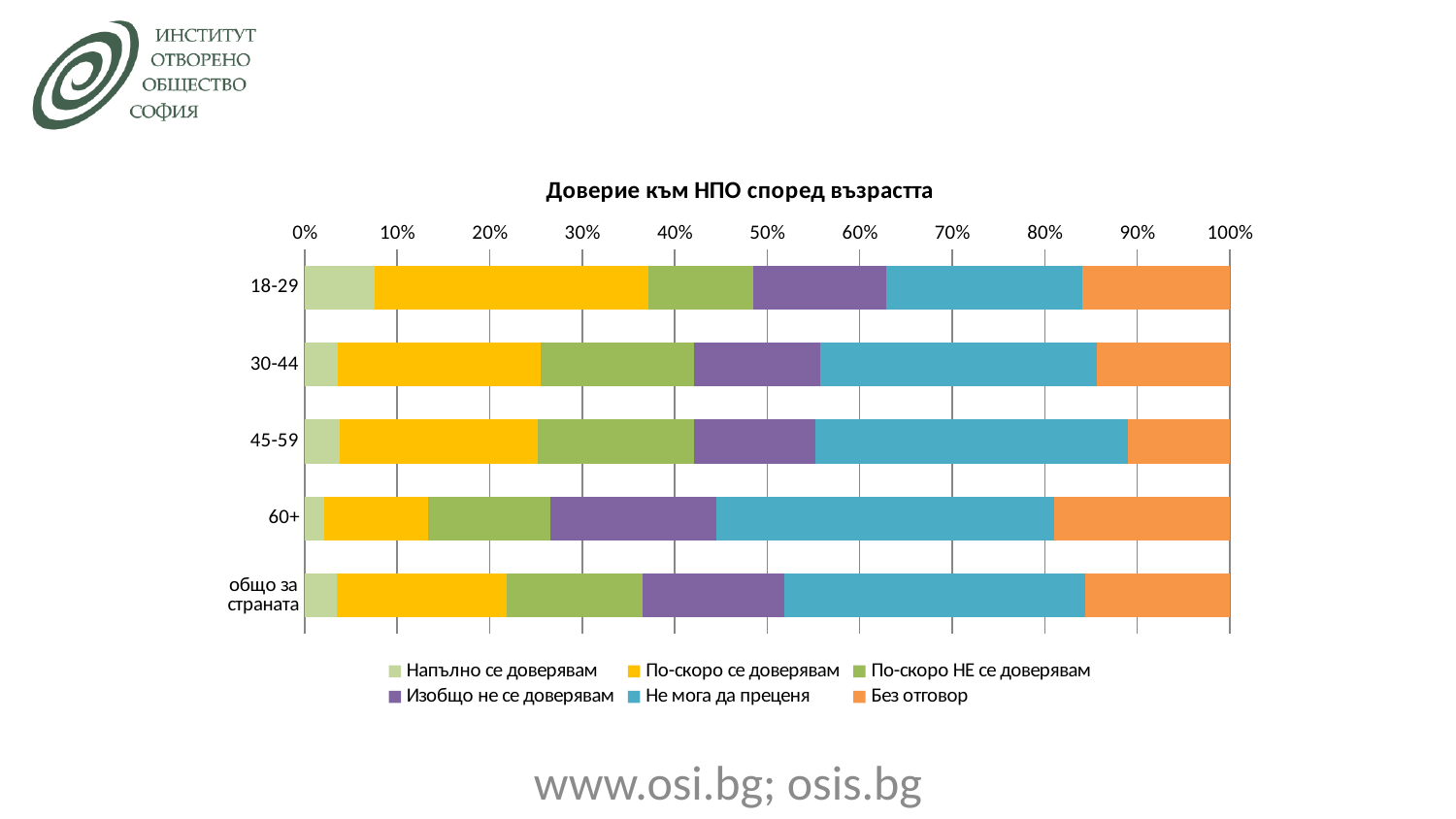
Which series is shown in orange in the legend? Без отговор What value does each stacked bar reach on the x axis? 100% Is the 'Напълно се доверявам' value for 60+ greater or less than 10%? less Which age group has the smallest 'По-скоро се доверявам' segment? 60+ What kind of chart is shown on the slide? Stacked bar chart Which age group has the smallest 'Не мога да преценя' segment? 18-29 What is the title of the chart? Доверие към НПО според възрастта Which is larger: the 'По-скоро се доверявам' segment for 18-29 or for 60+? 18-29 How many series does the legend list? 6 Which age group has the largest 'Напълно се доверявам' segment? 18-29 How many categories (age groups, including the national total) are shown on the chart? 5 Is the 'Напълно се доверявам' value for 18-29 greater or less than 10%? less